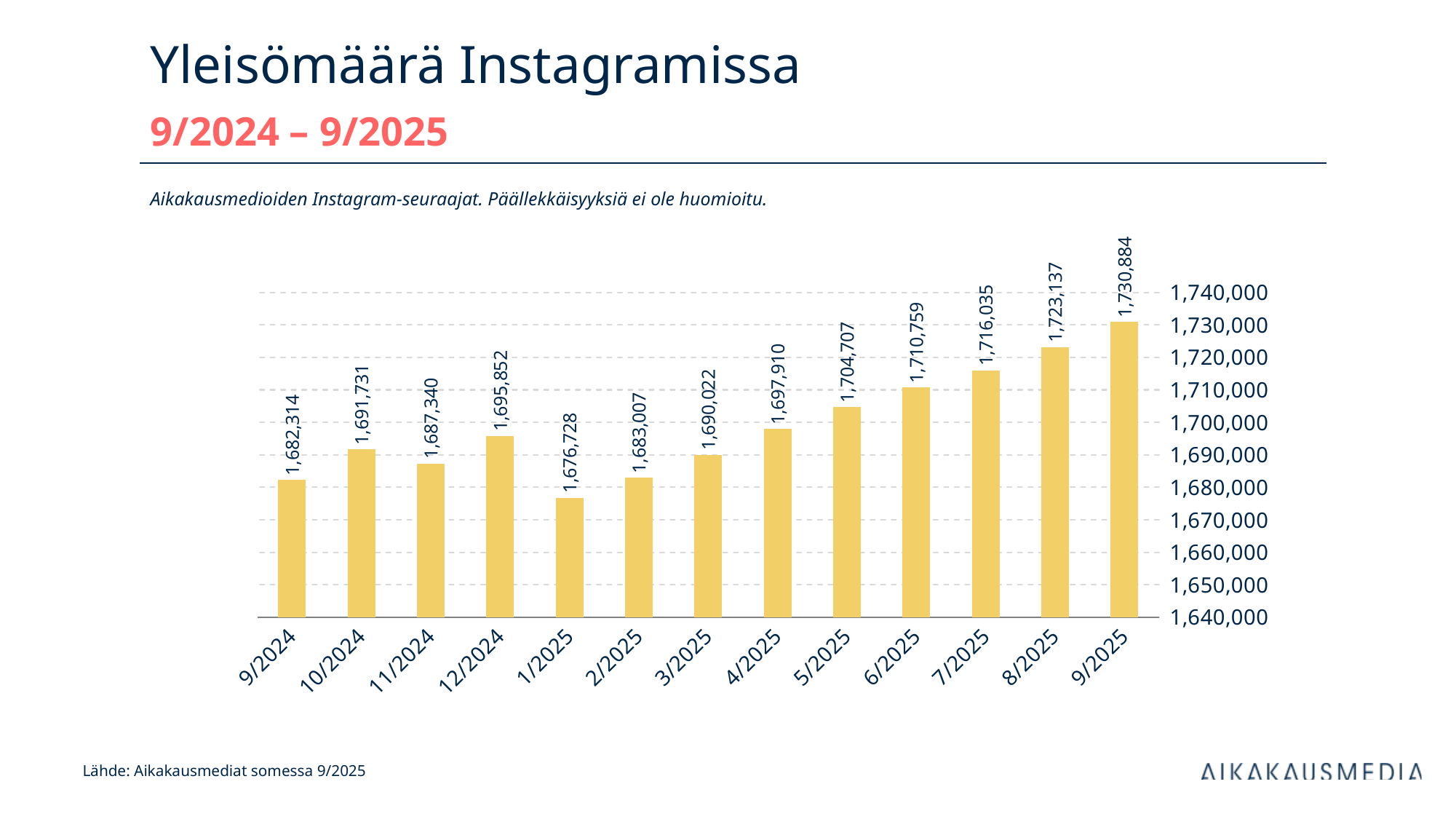
What is the difference between the values for 12/2024 and 1/2025? 19,124 Which month has the lowest value? 1/2025 What is the value for 9/2024? 1,682,314 What is the value for 1/2025? 1,676,728 Which is larger, the value for 10/2024 or the value for 11/2024? 10/2024 Is the value for 6/2025 greater or less than 1,700,000? greater Which month has the highest value? 9/2025 What is the value for 5/2025? 1,704,707 What period does the subtitle of the chart cover? 9/2024 – 9/2025 How many months are shown on the x axis? 13 What is the difference between the values for 9/2025 and 9/2024? 48,570 What kind of chart is shown on the slide? bar chart